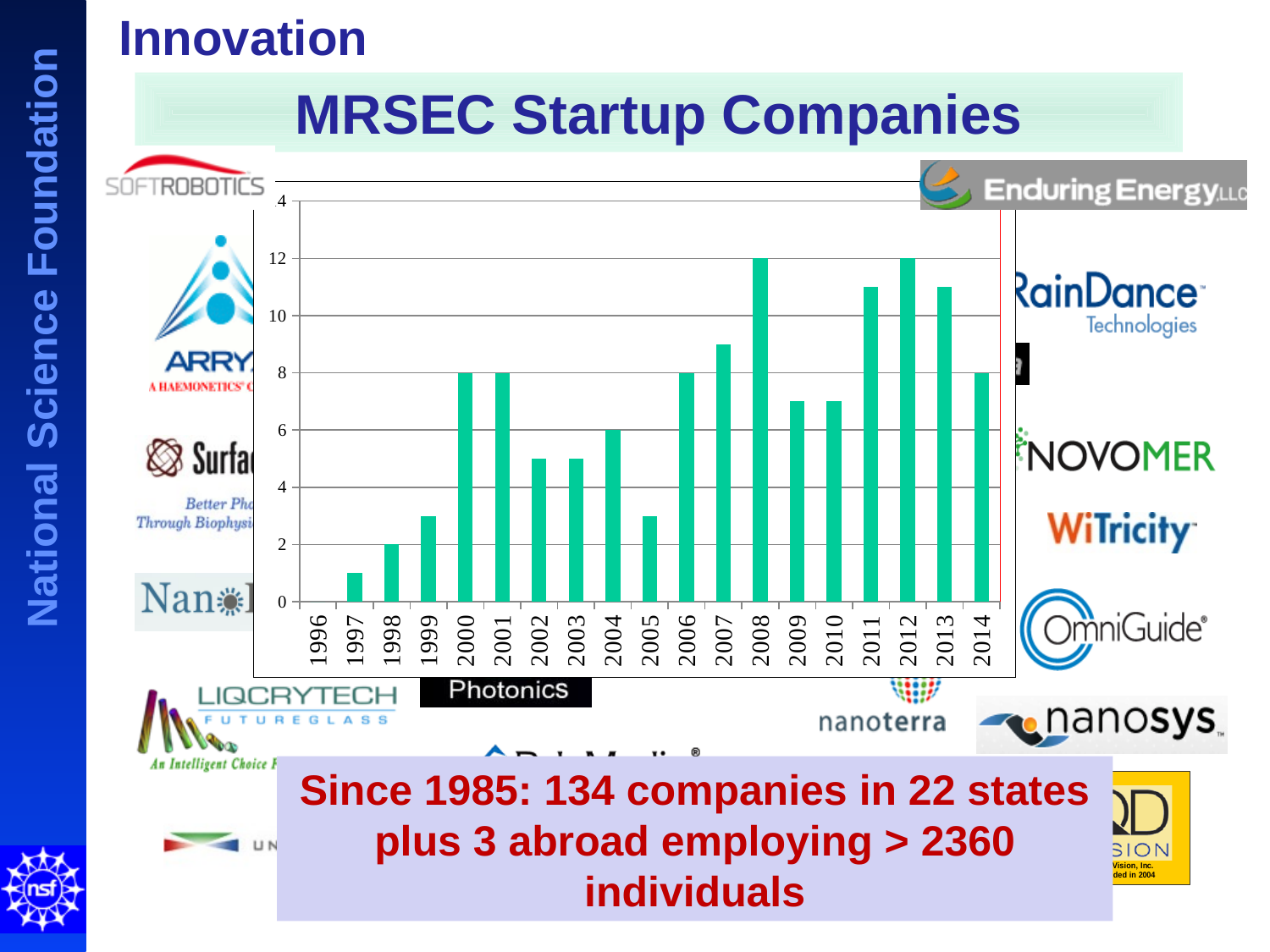
What kind of chart is shown on the slide? bar chart Is the value for 2005 greater or less than 4? less What is the title of the chart? MRSEC Startup Companies What is the value for 2008? 12 Which is larger, the value for 2008 or the value for 2009? 2008 What is the value for 2004? 6 Which year has the lowest value in the chart? 1996 What is the value for 1998? 2 What is the value for 2000? 8 How many years are shown on the x axis of the chart? 19 What is the highest value reached by any bar in the chart? 12 Is the value for 2011 greater or less than 10? greater